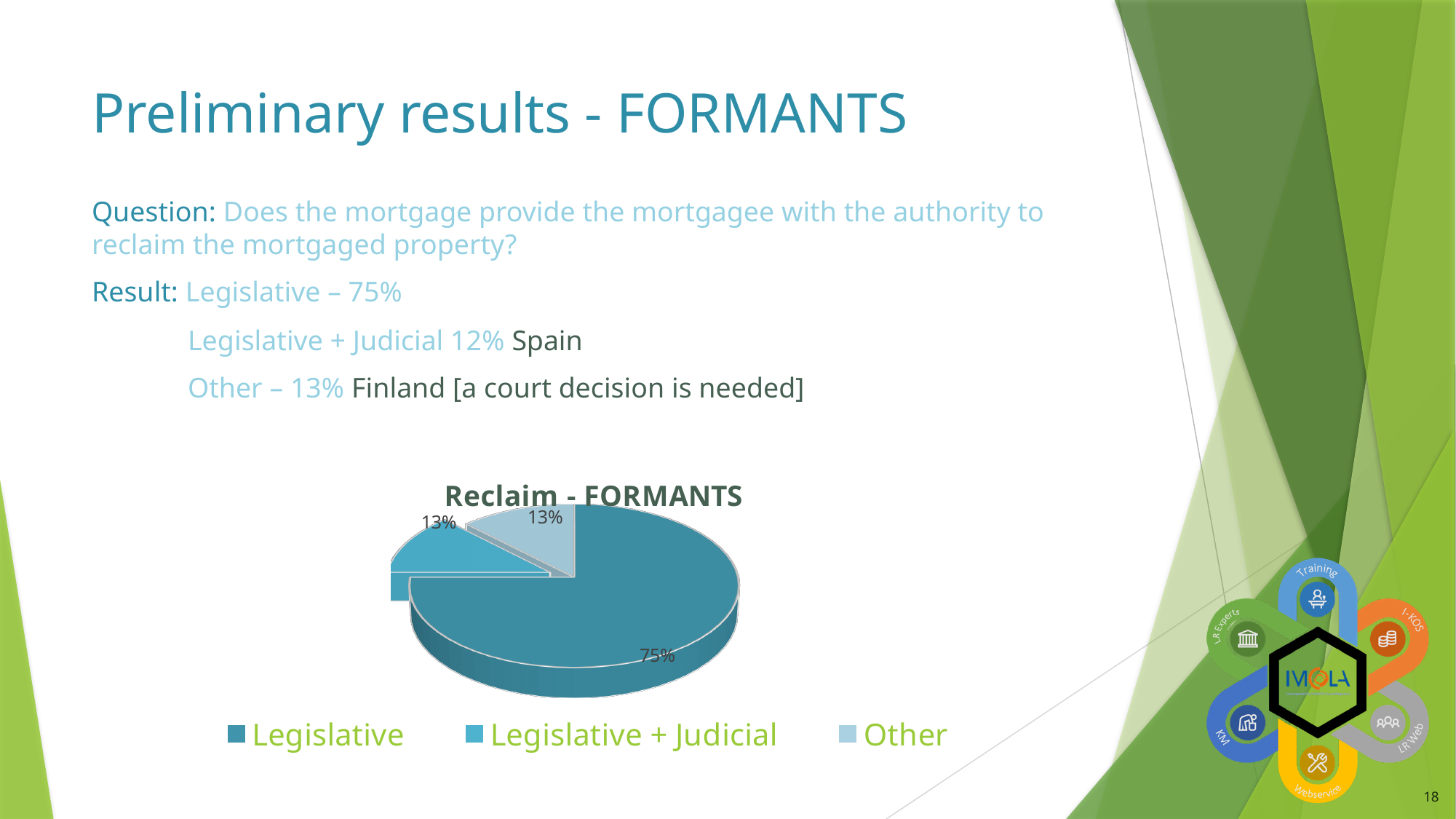
What type of chart is shown on the slide? pie chart What percentage does the Legislative slice show in the chart? 75% What share of the pie does the Legislative slice represent? 75% How many entries does the chart legend list? 3 Which is larger in the chart, the Legislative slice or the Other slice? Legislative What is the difference between the Legislative slice (75%) and the Other slice (13%)? 62% What is the title of the chart? Reclaim - FORMANTS What percentage does the Other slice show in the chart? 13% Which category has the largest slice in the pie chart? Legislative Which legend entry is shown in the lightest blue colour? Other How many slices does the pie chart have? 3